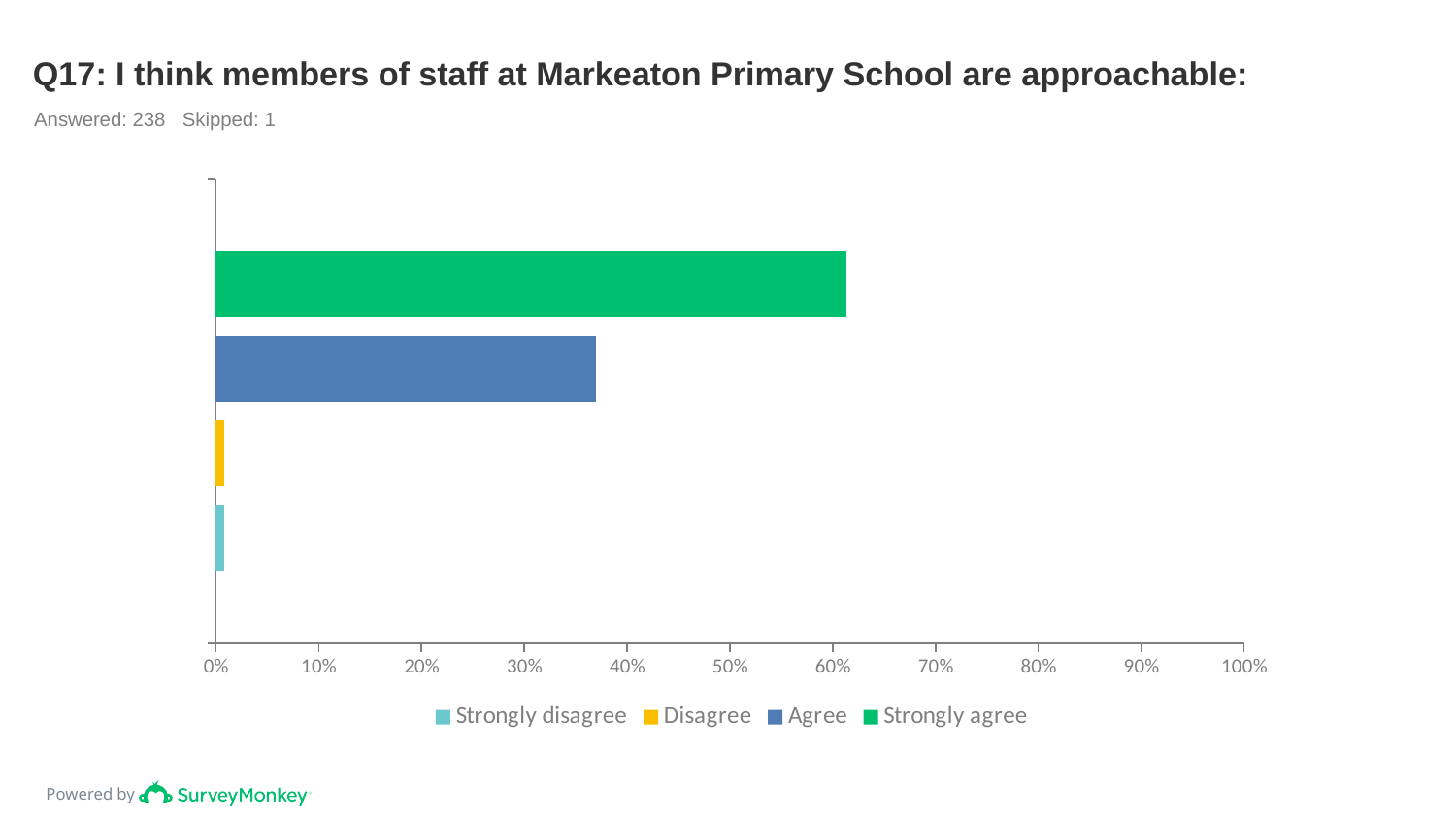
What kind of chart is shown on the slide? bar chart Is the value for Agree greater or less than 30%? greater Which is larger, the value for Strongly agree or the value for Agree? Strongly agree Is the value for Strongly disagree greater or less than 10%? less Is the value for Agree greater or less than 40%? less How many series does the legend list? 4 Which is larger, the value for Agree or the value for Disagree? Agree What colour is the bar for Strongly agree? green Which response option has the highest value? Strongly agree